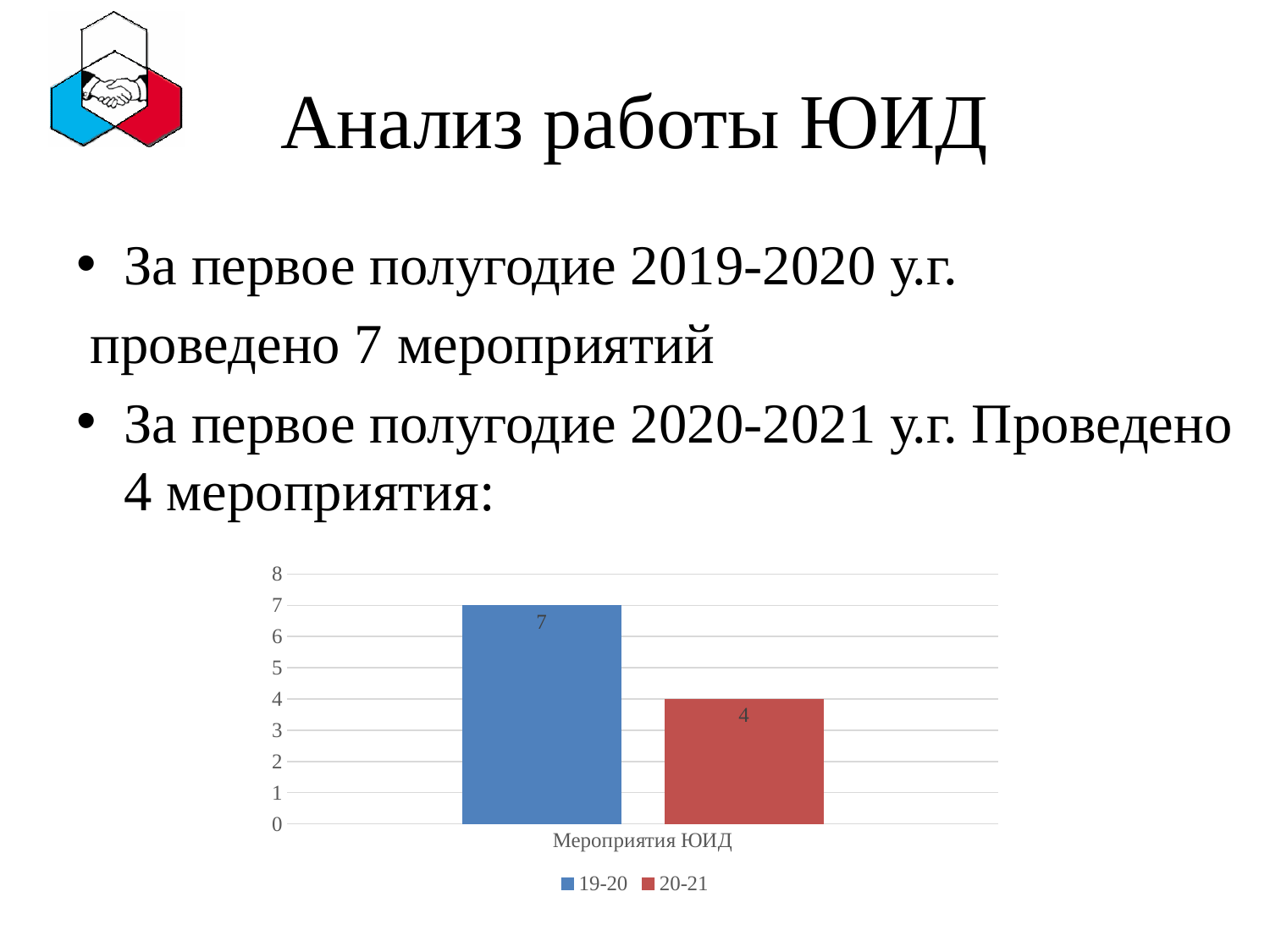
How many series does the legend list? 2 What colour is the bar for the 20-21 series? Red Which series has the lower value in the chart? 20-21 What is the difference between the 19-20 value and the 20-21 value? 3 What is the maximum value shown on the y axis of the chart? 8 What kind of chart is shown on the slide? Bar chart Is the value for 20-21 larger than the value for 19-20? No Which series has the higher value, 19-20 or 20-21? 19-20 What is the value for the 19-20 series in the chart? 7 What is the category label on the x axis of the chart? Мероприятия ЮИД What is the value for the 20-21 series in the chart? 4 Is the value for 19-20 greater or less than 5? greater